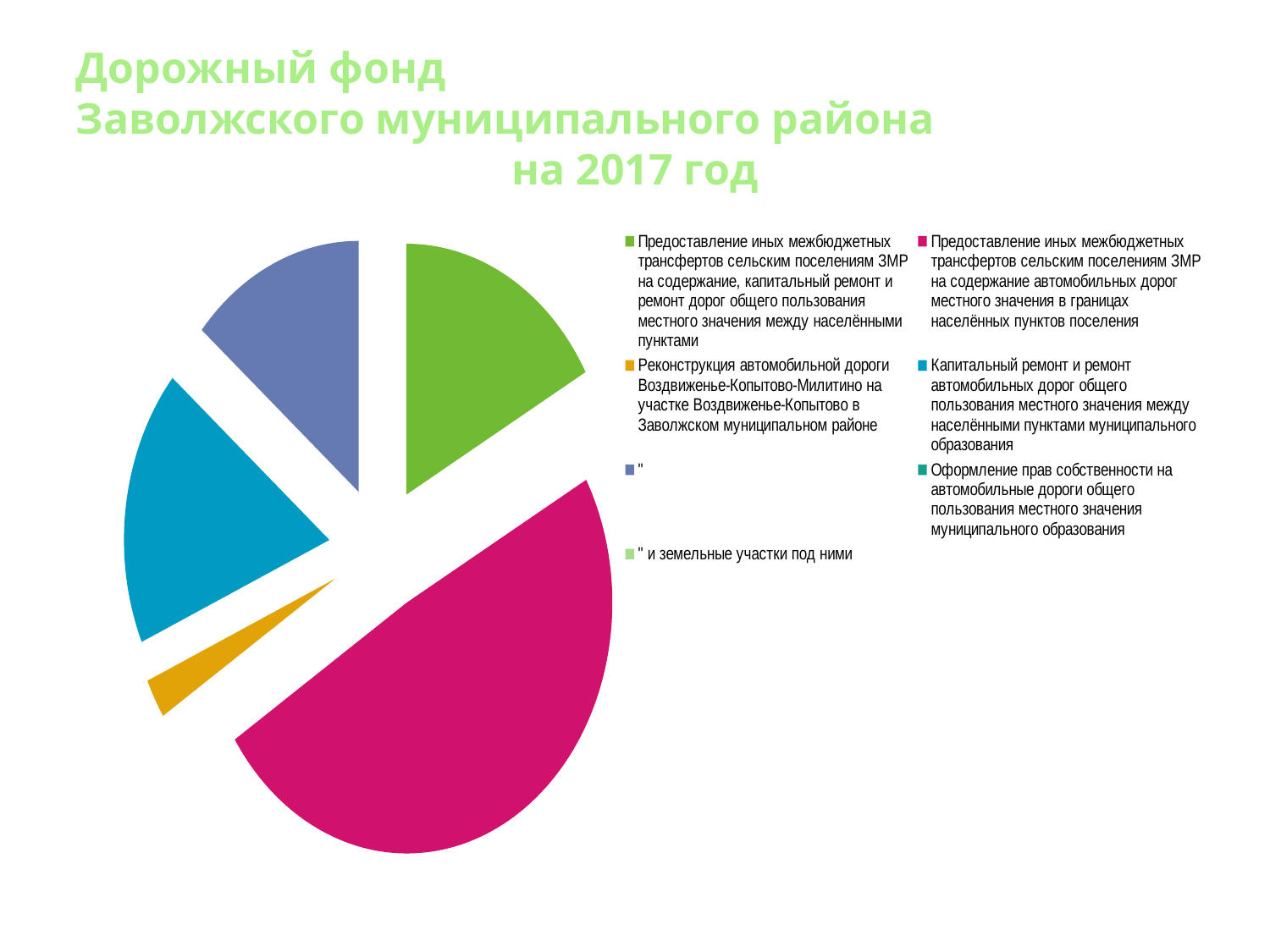
Which of the visible slices is the smallest? Реконструкция автомобильной дороги Воздвиженье-Копытово-Милитино на участке Воздвиженье-Копытово в Заволжском муниципальном районе What kind of chart is shown on the slide? pie chart What is the title of the slide containing the chart? Дорожный фонд Заволжского муниципального района на 2017 год Which category has the largest slice of the pie? Предоставление иных межбюджетных трансфертов сельским поселениям ЗМР на содержание автомобильных дорог местного значения в границах населённых пунктов поселения How many entries does the legend list? 7 Which slice is larger: the one for transfers for roads within settlement boundaries (magenta) or the one for transfers for roads between settlements (green)? Предоставление иных межбюджетных трансфертов сельским поселениям ЗМР на содержание автомобильных дорог местного значения в границах населённых пунктов поселения Which slice is larger: the cyan slice (Капитальный ремонт и ремонт автомобильных дорог) or the orange slice (Реконструкция автомобильной дороги Воздвиженье-Копытово-Милитино)? Капитальный ремонт и ремонт автомобильных дорог общего пользования местного значения между населёнными пунктами муниципального образования What colour is the slice for Реконструкция автомобильной дороги Воздвиженье-Копытово-Милитино? orange How many slices are visible in the pie chart? 5